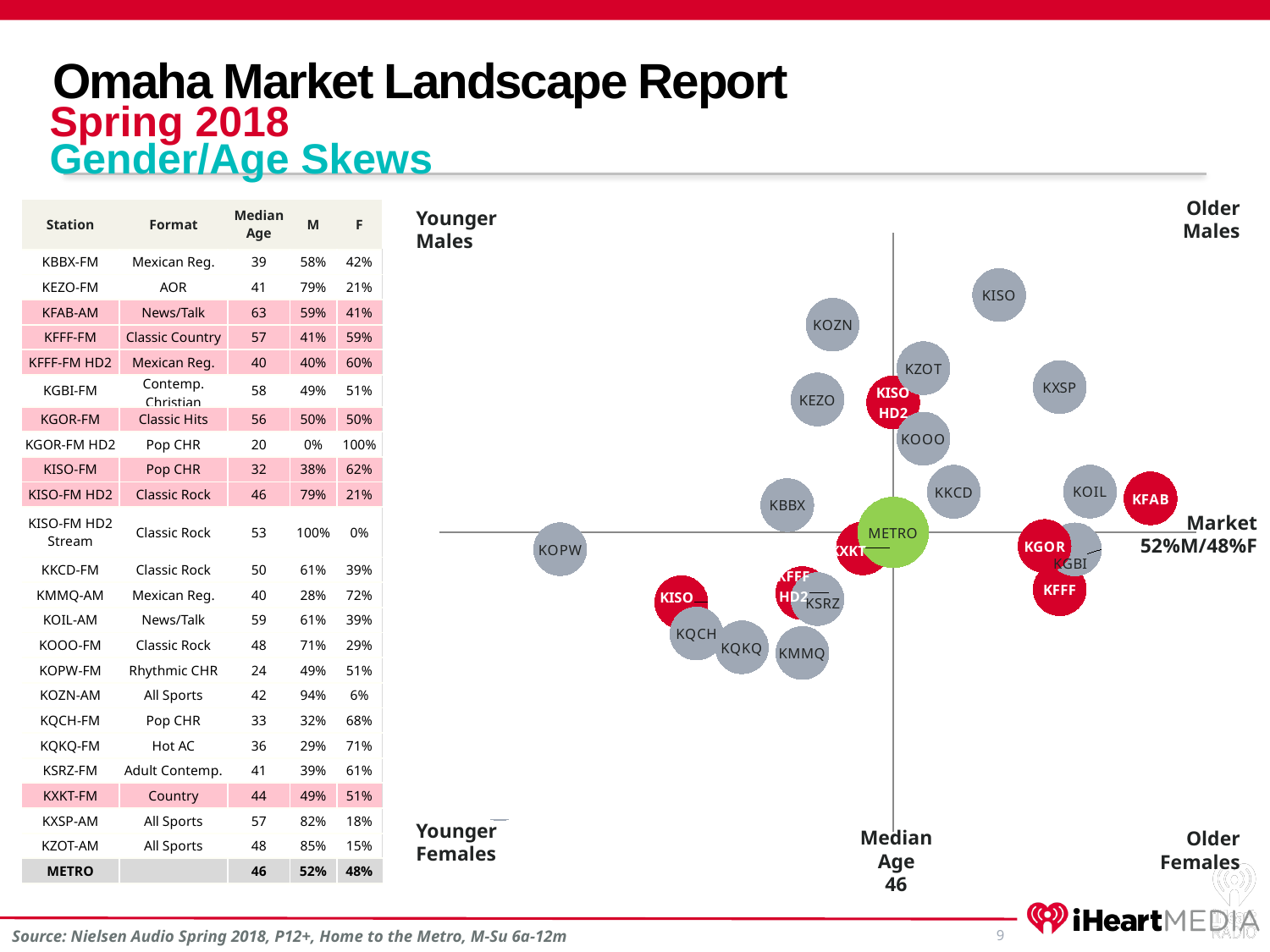
What market gender split is printed at the right end of the chart's horizontal axis? 52%M/48%F In which quadrant of the chart is KMMQ plotted? Younger Females What kind of chart is shown on the slide? bubble chart Which station bubble is plotted highest (most male-skewed) on the chart? KISO Which station bubble is plotted furthest to the left (youngest) on the chart? KOPW What median age is shown for the Metro on the chart's vertical axis label? 46 Is the median age for KOPW greater or less than the Metro median age of 46? less Which station bubble is plotted closest to the METRO bubble on the chart? KXKT Is the median age for KFAB greater or less than the Metro median age of 46? greater In which quadrant of the chart is KOZN plotted? Younger Males Which station bubble is plotted furthest to the right (oldest) on the chart? KFAB Which station is plotted further to the right on the chart, KFAB or KOPW? KFAB